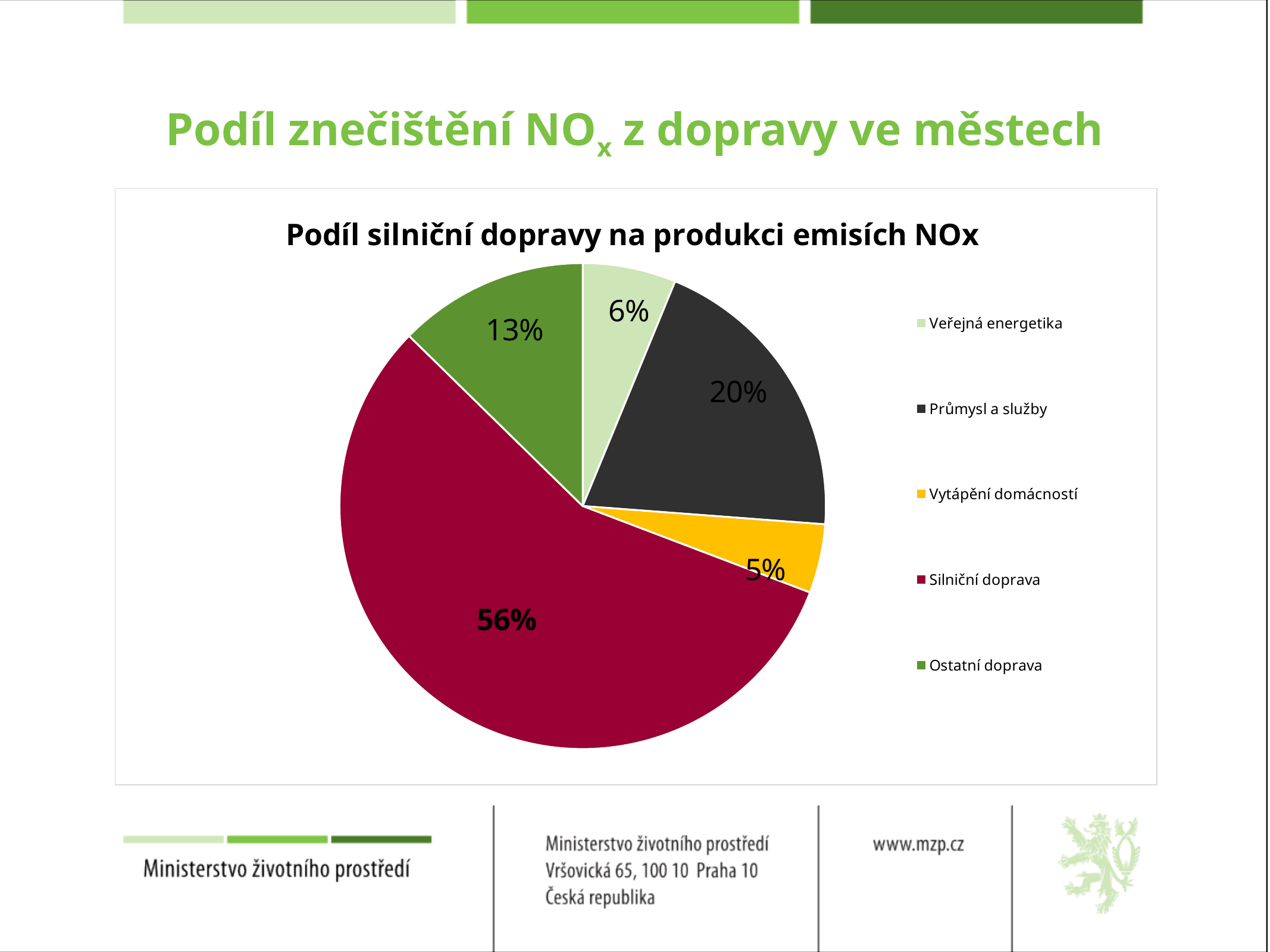
What is the difference between the shares of Silniční doprava and Průmysl a služby? 36% What kind of chart is shown on the slide? pie chart What share of the pie does Průmysl a služby have? 20% How many categories does the pie chart show? 5 What share of the pie does Vytápění domácností have? 5% What share of the pie does Silniční doprava have? 56% Which category has the largest share of the pie? Silniční doprava What is the title of the chart? Podíl silniční dopravy na produkci emisích NOx Which is larger, the share of Ostatní doprava or the share of Veřejná energetika? Ostatní doprava Which category has the smallest share of the pie? Vytápění domácností